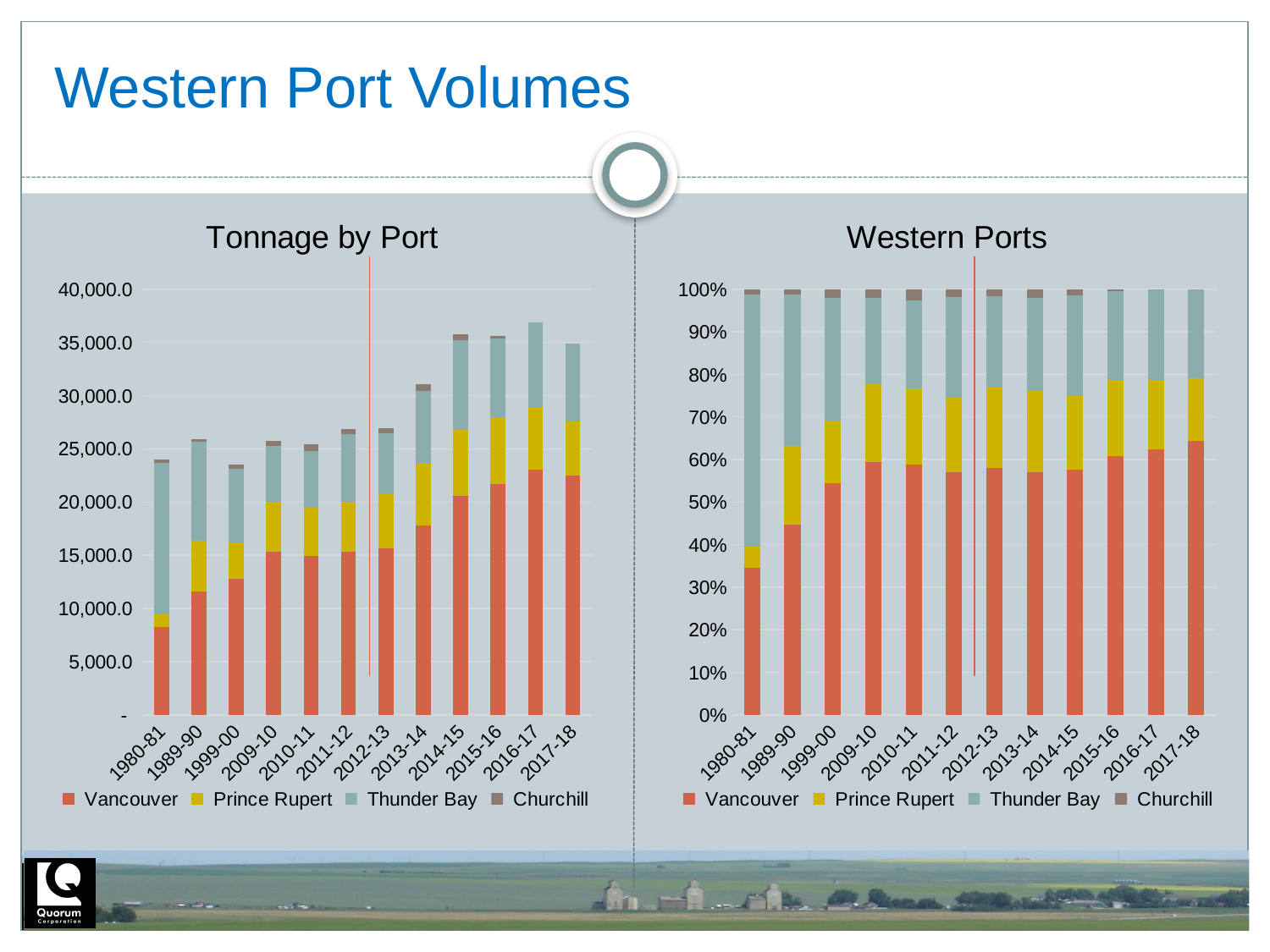
How many crop years are shown along the x axis of the "Tonnage by Port" chart? 12 In the "Western Ports" chart, does the Vancouver share generally rise or fall from 1980-81 to 2017-18? Rise In the "Tonnage by Port" chart, which crop year has the tallest total bar? 2016-17 In the "Tonnage by Port" chart, is the total bar for 2016-17 greater or less than 35,000.0? greater In the "Western Ports" chart, is the Vancouver share for 2017-18 greater or less than 60%? greater In the "Tonnage by Port" chart, is the Vancouver value for 2017-18 greater or less than 20,000.0? greater How many series does the legend of the "Western Ports" chart list? 4 In the "Tonnage by Port" chart, which series is shown in orange? Vancouver In the "Tonnage by Port" chart, which crop year has the smallest Vancouver segment? 1980-81 What kind of chart is the "Tonnage by Port" chart on the left? Stacked bar chart